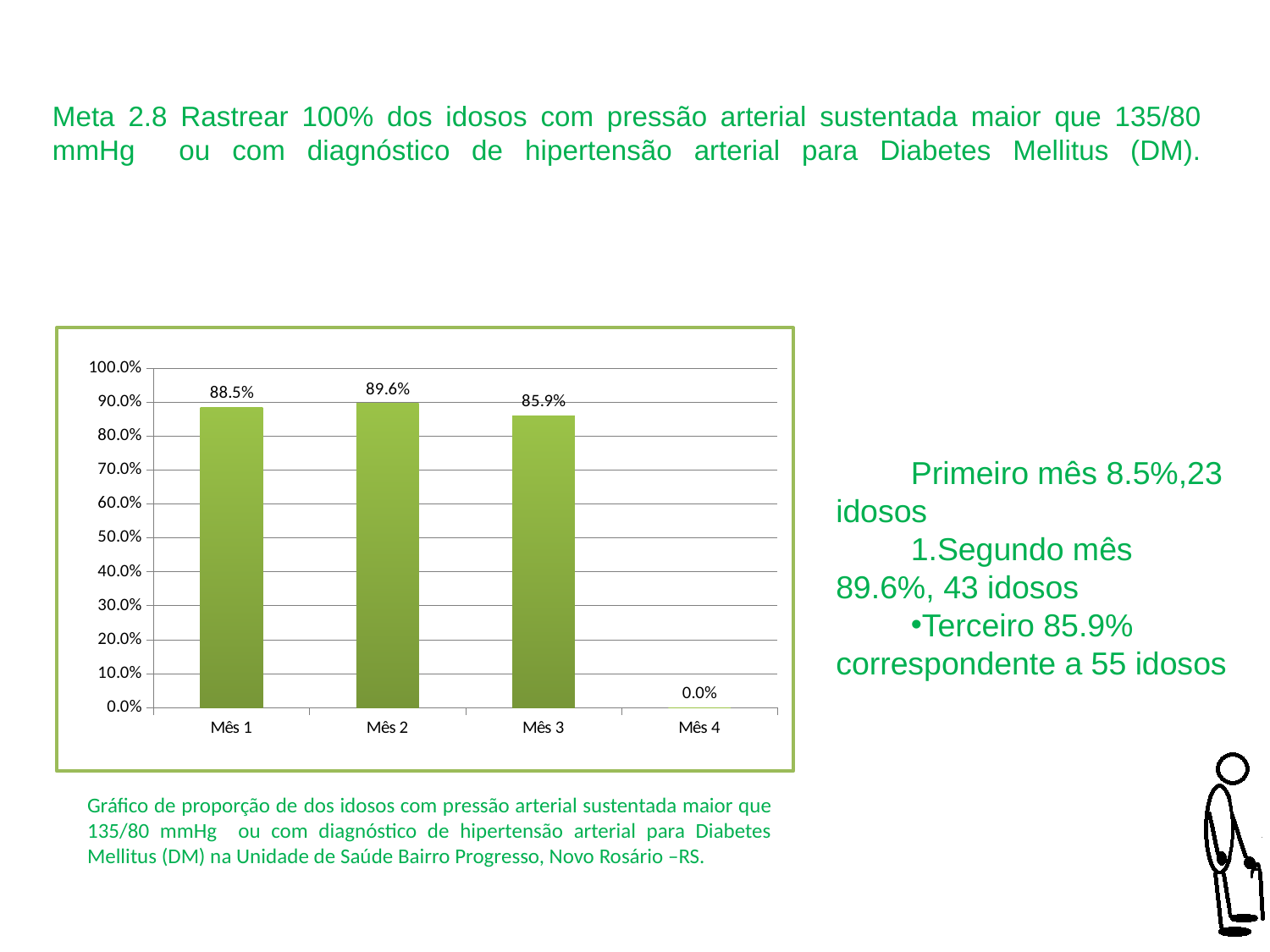
What is the value for Mês 2? 89.6% What is the difference between the values for Mês 2 and Mês 3? 3.7% What is the value for Mês 3? 85.9% What kind of chart is shown on the slide? bar chart Which month has the lowest value? Mês 4 What is the value for Mês 4? 0.0% How many months are shown on the x axis? 4 What is the value for Mês 1? 88.5% Which is larger, the value for Mês 1 or the value for Mês 3? Mês 1 Which month has the highest value? Mês 2 Is the value for Mês 3 greater or less than 80.0%? greater What is the highest value shown on the y axis? 100.0%